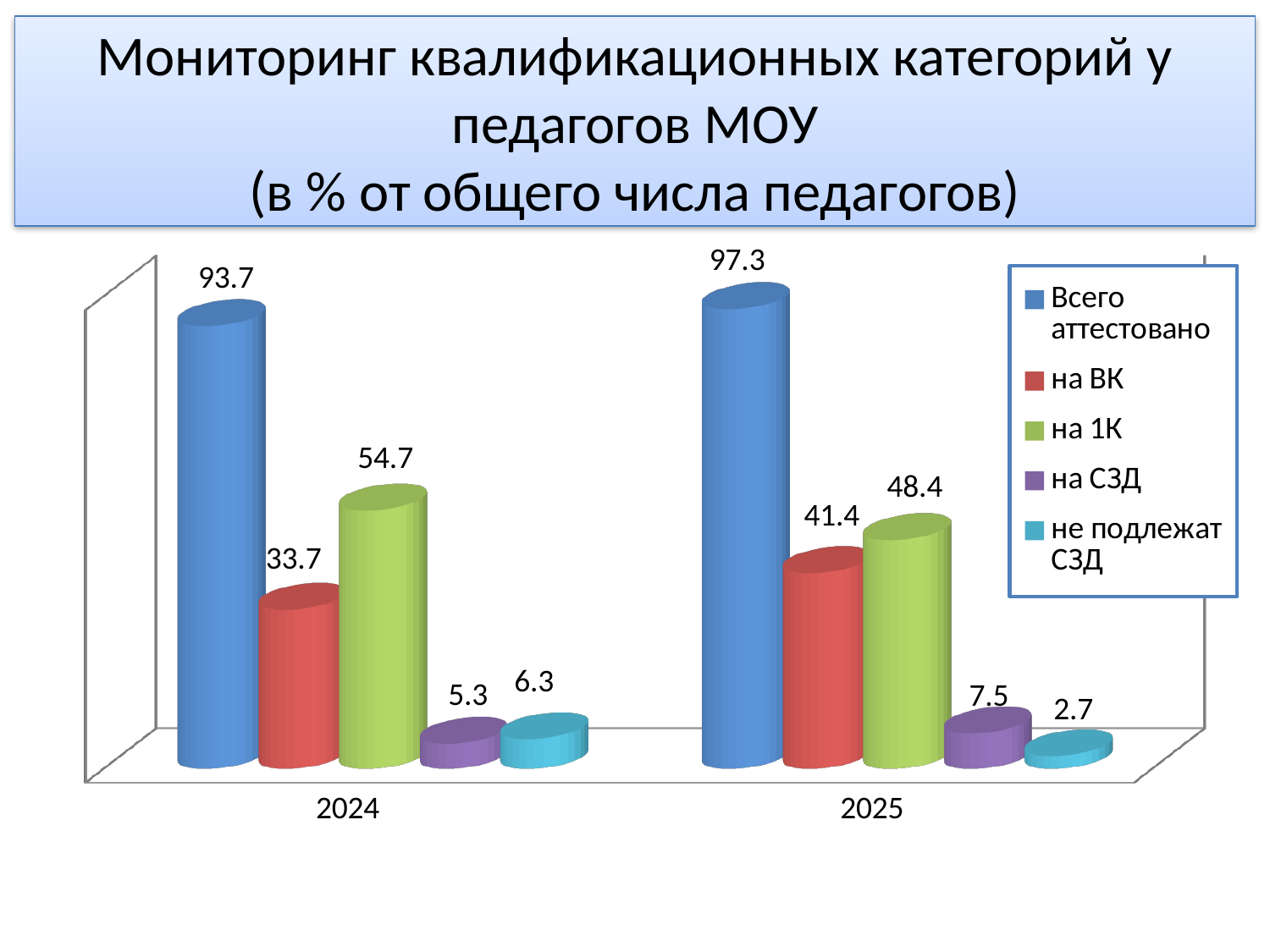
What kind of chart is shown on the slide? Bar chart What is the value for "на СЗД" in 2024? 5.3 Which series has the lowest value in 2024? на СЗД What is the value for "не подлежат СЗД" in 2025? 2.7 Which is larger: "на 1К" in 2024 or "на 1К" in 2025? 2024 What is the value for "на ВК" in 2025? 41.4 What is the value for "Всего аттестовано" in 2024? 93.7 How many categories are shown on the x axis? 2 Does the value for "на ВК" rise or fall from 2024 to 2025? Rise What is the difference between "Всего аттестовано" in 2025 and in 2024? 3.6 How many series does the legend list? 5 Which series has the highest value in 2025? Всего аттестовано